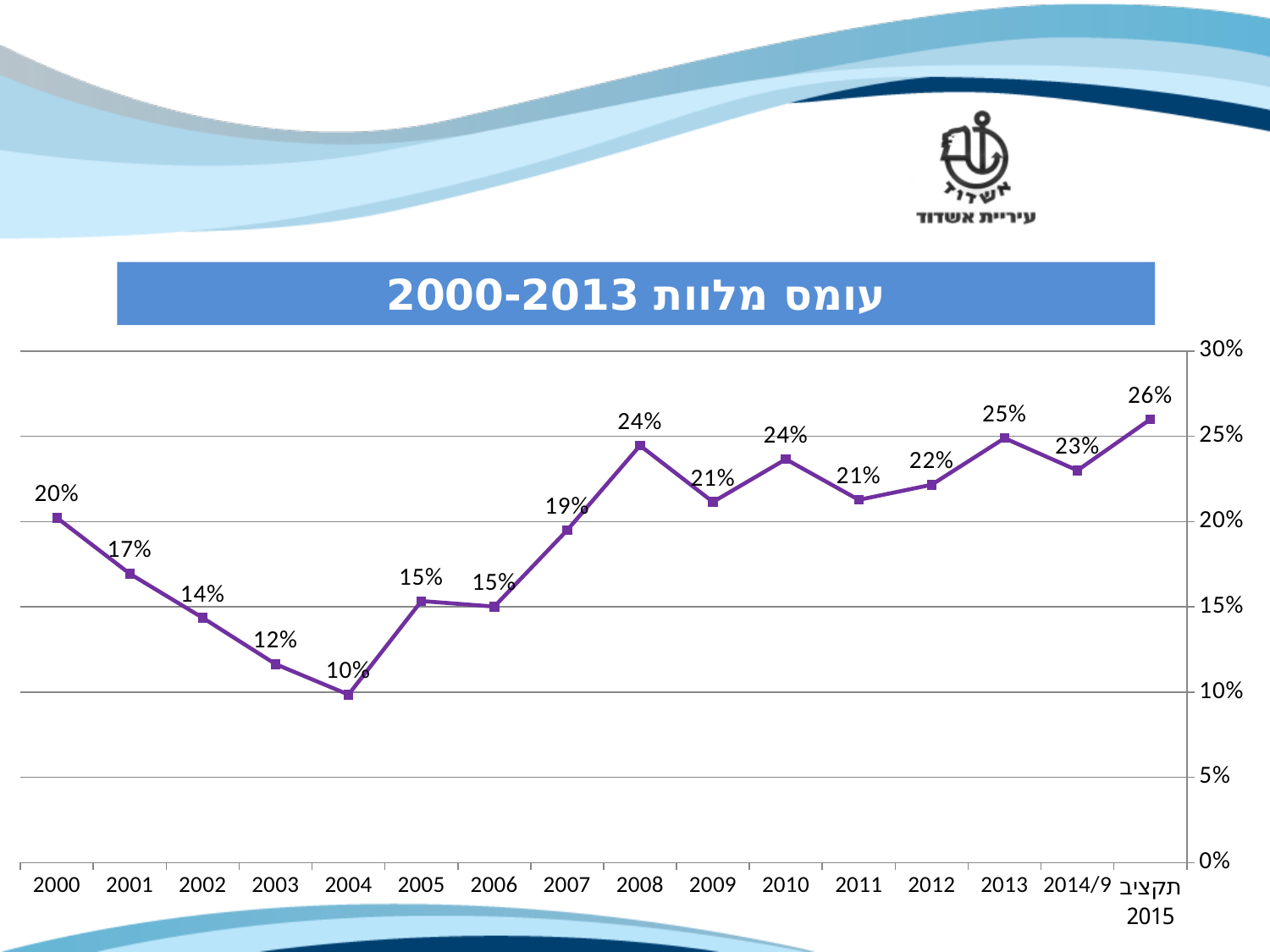
What is the value for 2000? 20% Which is larger, the value for 2007 or the value for 2009? 2009 What is the title of the chart? עומס מלוות 2000-2013 What kind of chart is shown on the slide? line chart Which category has the highest value? תקציב 2015 Which category has the lowest value? 2004 Do the values rise or fall from 2000 to 2004? fall What is the value for 2014/9? 23% What is the value for 2008? 24% What is the value for 2004? 10% How many data points are plotted on the chart? 16 What is the difference between the values for 2013 and 2012? 3%